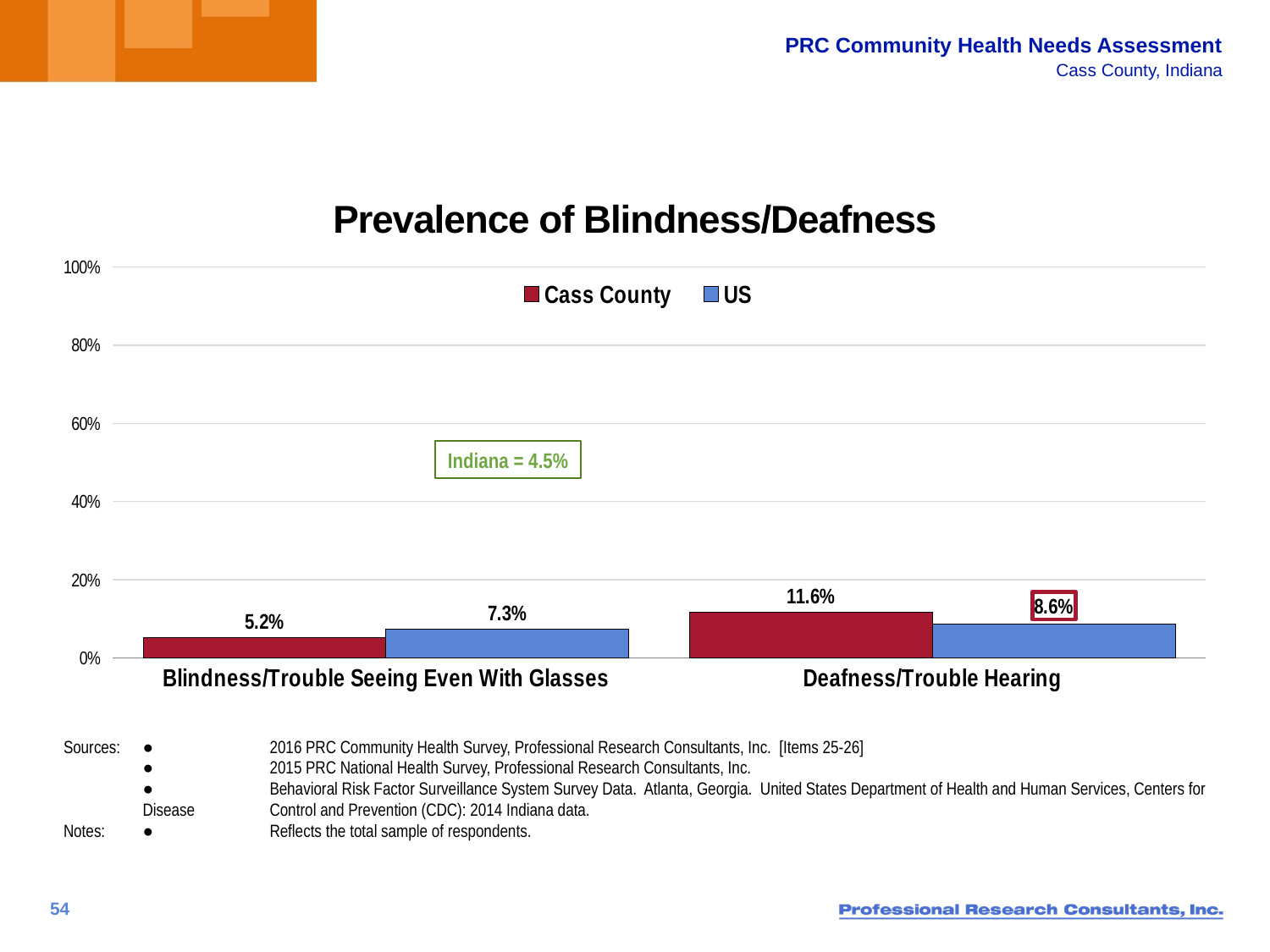
What is the Cass County value for Deafness/Trouble Hearing? 11.6% How many series does the legend list? 2 What kind of chart is shown? bar chart What is the US value for Deafness/Trouble Hearing? 8.6% What is the Cass County value for Blindness/Trouble Seeing Even With Glasses? 5.2% What is the difference between the Cass County and US values for Deafness/Trouble Hearing? 3.0% Which category has the highest Cass County value? Deafness/Trouble Hearing How many categories are shown on the x axis? 2 For Blindness/Trouble Seeing Even With Glasses, which is larger: the Cass County value or the US value? US What is the US value for Blindness/Trouble Seeing Even With Glasses? 7.3% Which category has the lowest US value? Blindness/Trouble Seeing Even With Glasses Is the Cass County value for Deafness/Trouble Hearing greater or less than 20%? less